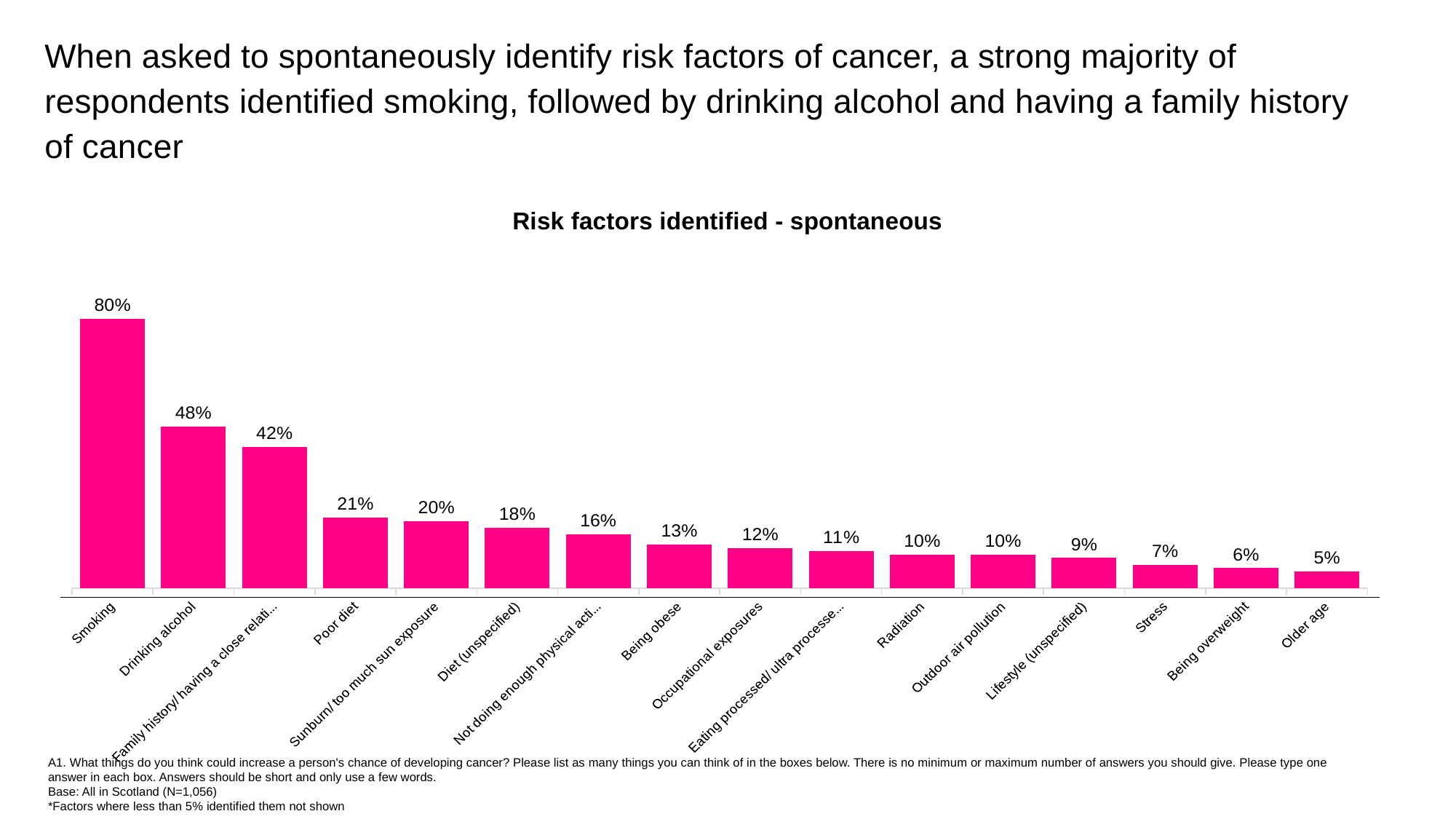
Do the values rise or fall from left to right along the x axis? Fall What is the value for Poor diet? 21% Which risk factor has the lowest value shown? Older age What kind of chart is shown on the slide? Bar chart What is the value for Radiation? 10% What is the title of the chart? Risk factors identified - spontaneous What percentage of respondents identified smoking as a risk factor? 80% What is the difference between the values for Smoking and Drinking alcohol? 32% Which risk factor has the highest value? Smoking How many risk factors are shown in the chart? 16 Which is larger, the value for Being obese or the value for Stress? Being obese What is the value for Drinking alcohol? 48%